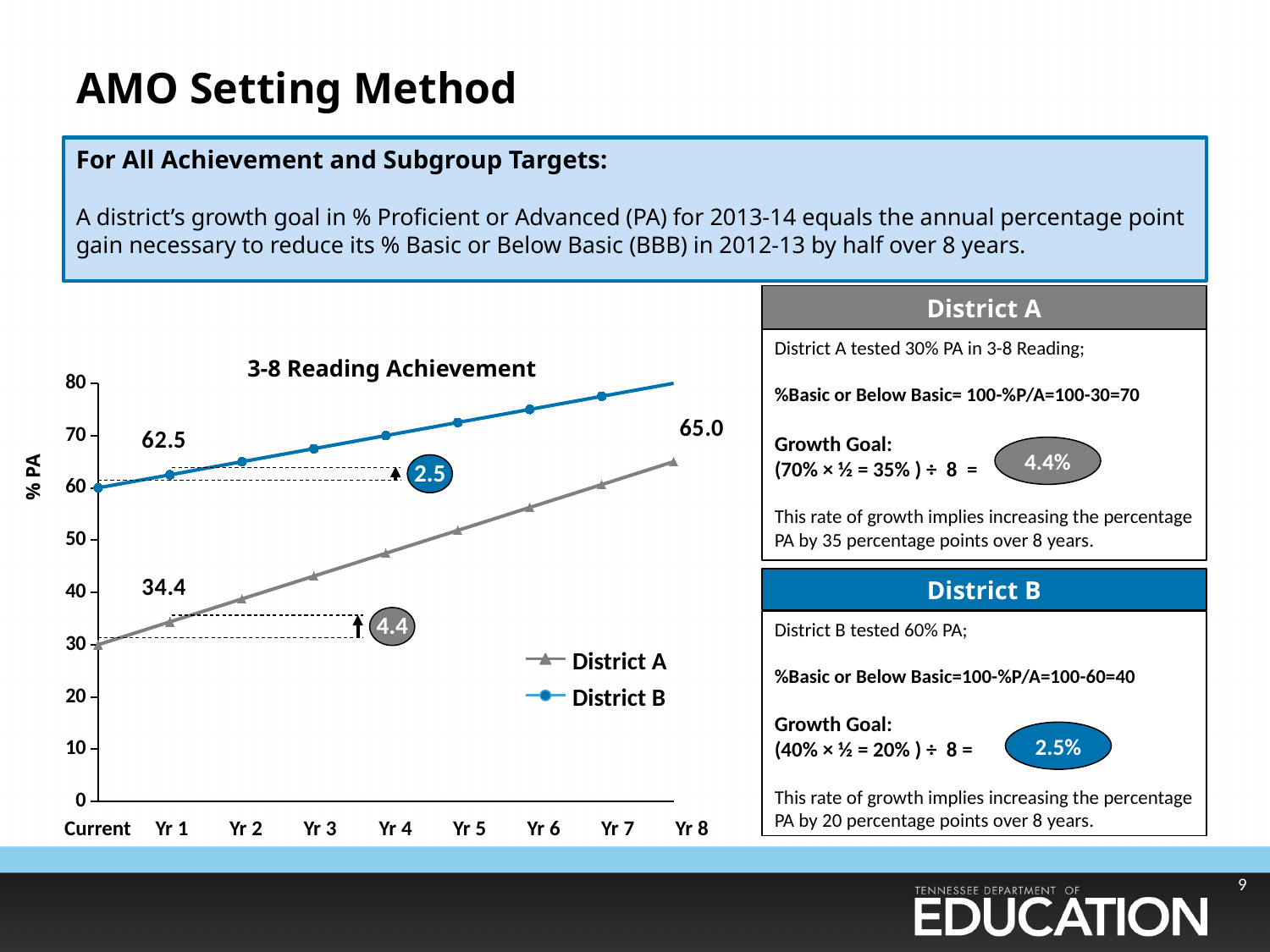
What is the value for District B at Yr 1? 62.5 Is the value for District A at Yr 6 greater or less than 50? greater How many series does the legend of the 3-8 Reading Achievement chart list? 2 What is the title of the chart? 3-8 Reading Achievement What is the value for District A at Current? 30 What is the value for District A at Yr 1? 34.4 What is the value for District A at Yr 8? 65.0 What is the difference between District B and District A at Yr 1? 28.1 How many points are on the x axis of the 3-8 Reading Achievement chart? 9 Do the values for District A rise or fall from Current to Yr 8? rise Which series has the larger value at Yr 4, District A or District B? District B What kind of chart is shown on the slide? line chart